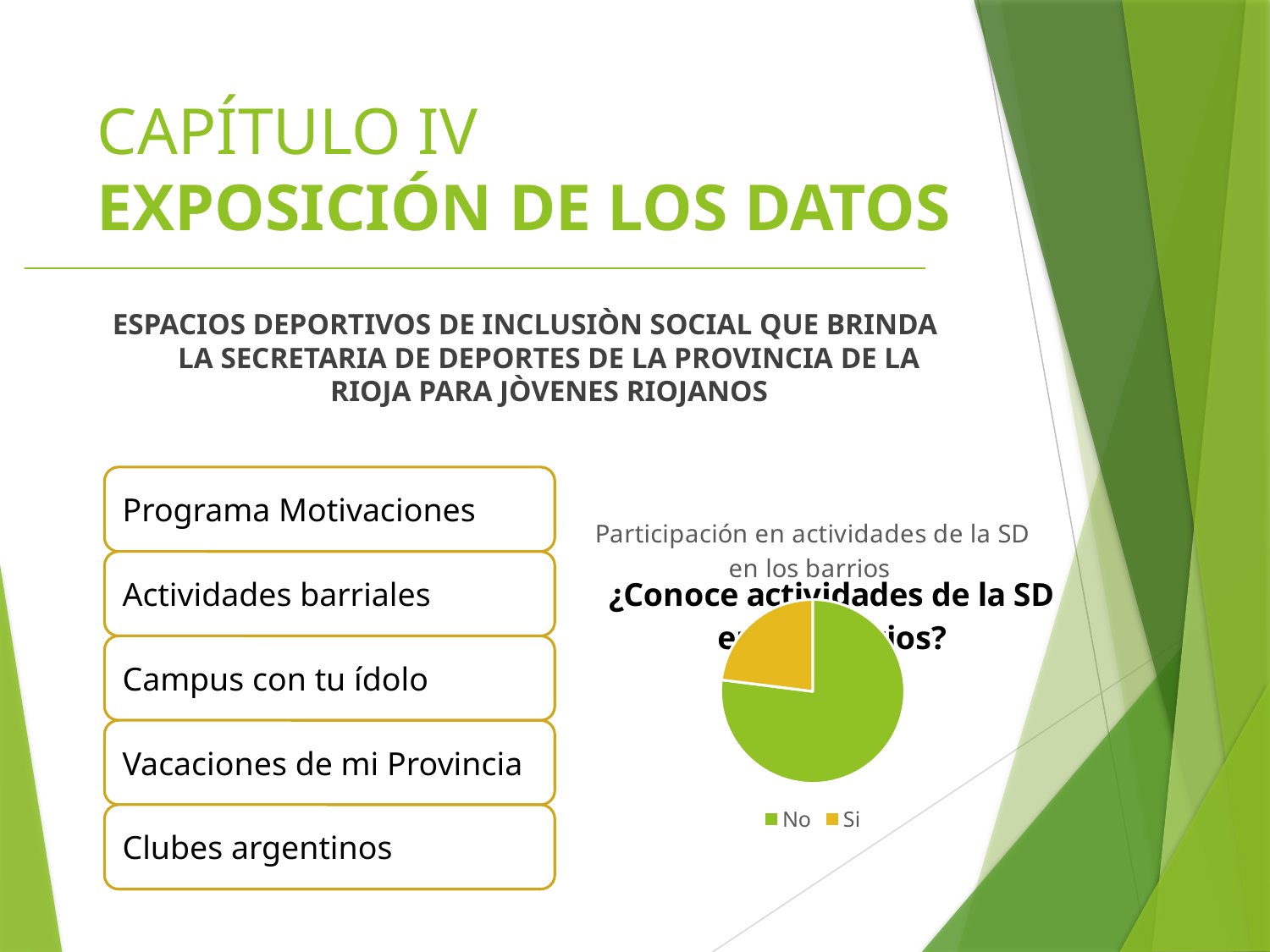
How many categories does the pie chart's legend list? 2 What kind of chart is shown on the slide? pie chart Which slice is larger in the pie chart, No or Si? No Which category has the smallest slice in the pie chart? Si What colour is the No slice in the pie chart? green What is the title of the pie chart? Participación en actividades de la SD en los barrios Which category has the largest slice in the pie chart? No